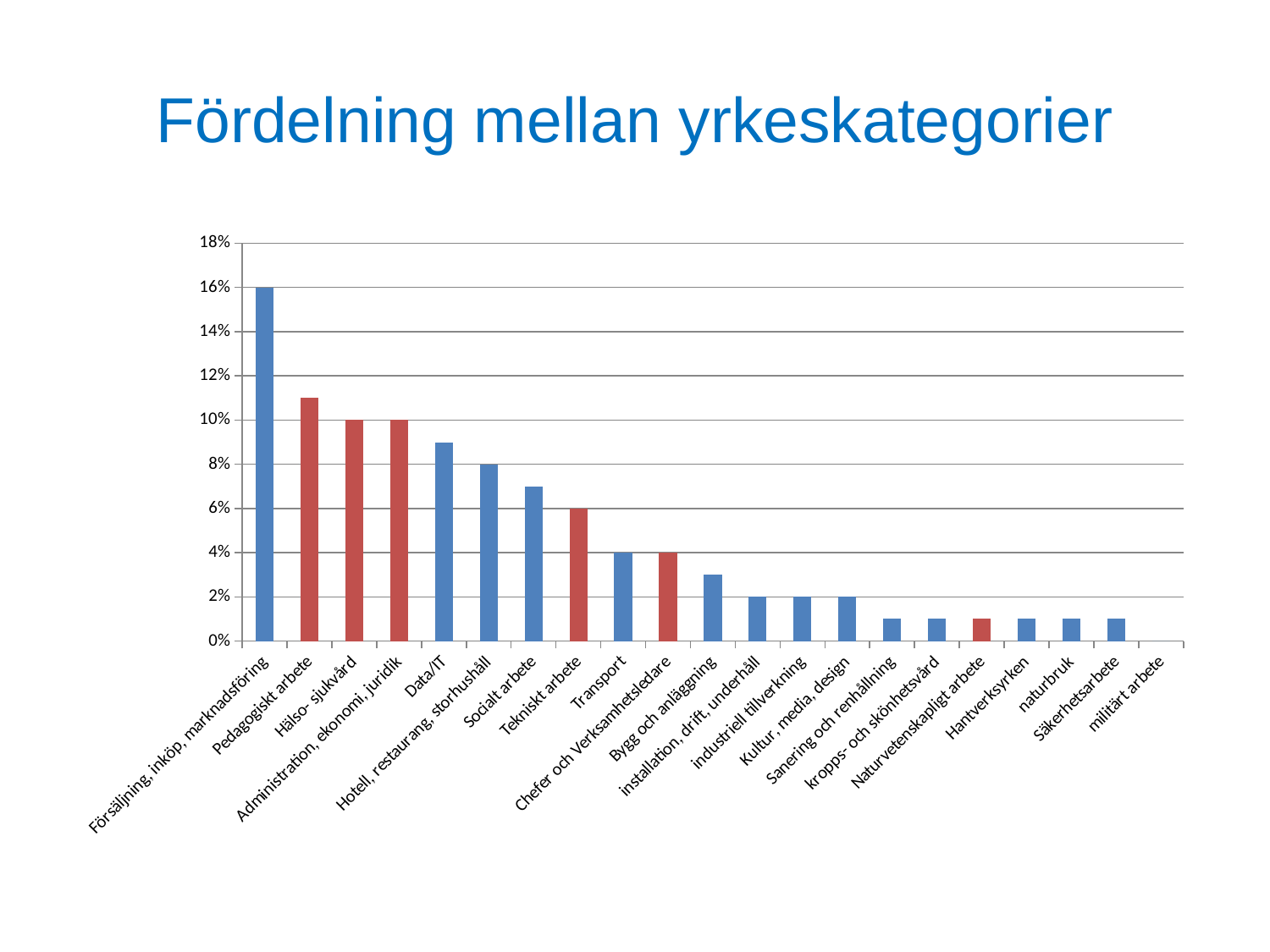
What is the title of the chart? Fördelning mellan yrkeskategorier Which category has the highest value? Försäljning, inköp, marknadsföring What is the value for Försäljning, inköp, marknadsföring? 16% What is the difference between the values for Försäljning, inköp, marknadsföring and Hälso- sjukvård? 6% Which is larger, the value for Hotell, restaurang, storhushåll or the value for Tekniskt arbete? Hotell, restaurang, storhushåll Do the values rise or fall from left to right along the x axis? fall What kind of chart is shown on the slide? bar chart Is the value for Data/IT greater or less than 10%? less What is the value for Hotell, restaurang, storhushåll? 8% Is the value for Pedagogiskt arbete greater or less than 10%? greater What is the value for Hälso- sjukvård? 10% What is the value for Tekniskt arbete? 6%